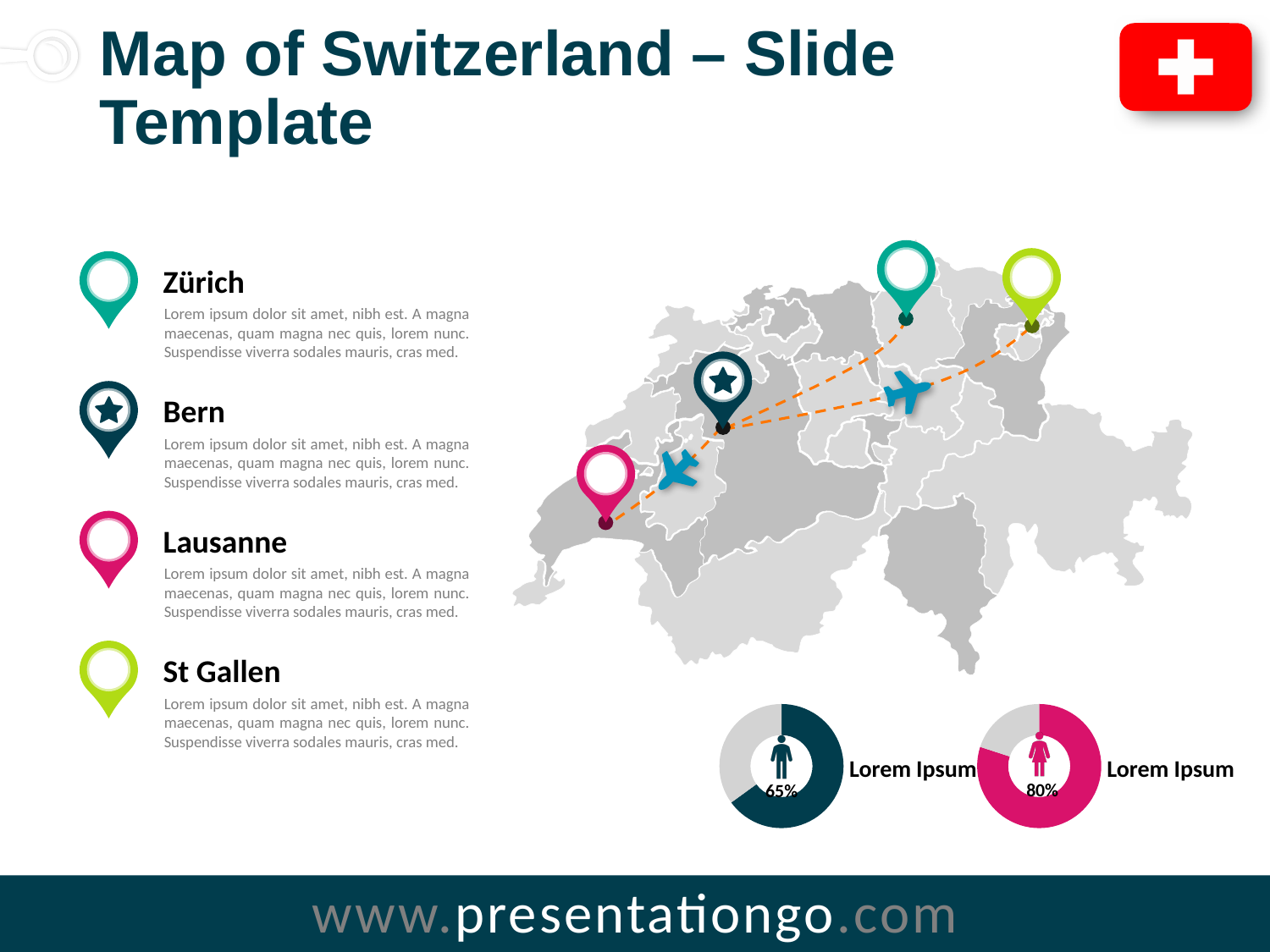
What share of the left donut chart is not filled by the 65% segment? 35% What is the difference between the percentages shown in the right donut chart and the left donut chart? 15 percentage points What colour is the filled segment of the right donut chart showing 80%? pink (magenta) What percentage is shown in the left donut chart at the bottom right of the slide? 65% What percentage is shown in the right donut chart at the bottom right of the slide? 80% Is the value shown in the left donut chart greater or less than 50%? greater What kind of chart is used to display the 65% and 80% values on the slide? donut (pie) chart What share of the right donut chart is not filled by the 80% segment? 20% What label text appears next to each of the two donut charts? Lorem Ipsum How many donut charts are shown on the slide? 2 Which of the two donut charts shows the larger percentage, the left one or the right one? the right one (80%)